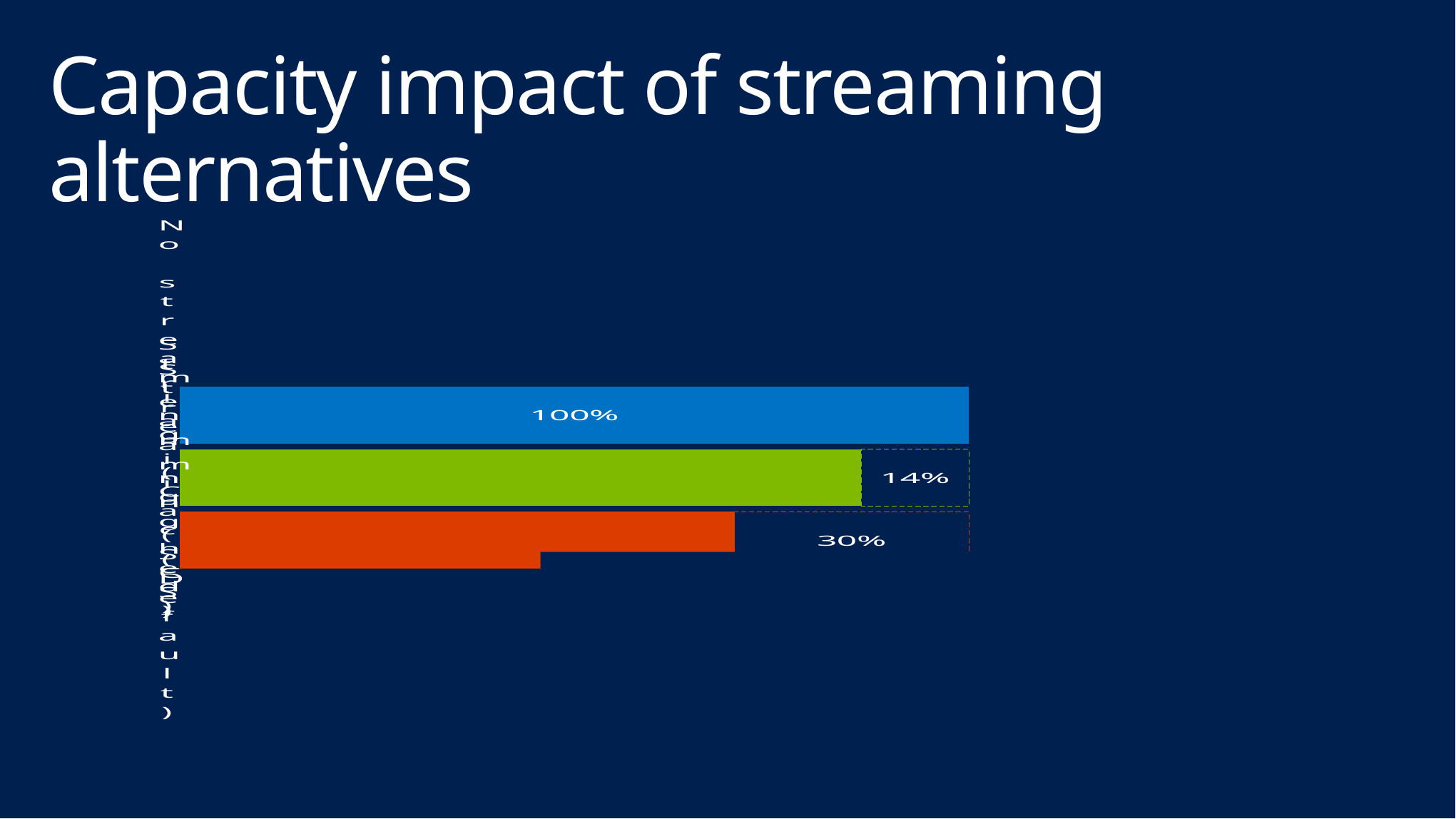
What is the difference between the labelled values of the top (blue) bar and the middle (green) bar? 86% What value is labelled on the top (blue) bar? 100% What colour is the bar labelled 100%? blue Which bar has the highest labelled value? the top (blue) bar, 100% What is the title of the slide containing the chart? Capacity impact of streaming alternatives How many bars are plotted in the chart? 3 What value is labelled on the middle (green) bar? 14% Which bar has the smallest labelled value? the middle (green) bar, 14% What value is labelled on the bottom (red) bar? 30% What is the difference between the labelled values of the bottom (red) bar and the middle (green) bar? 16% Which has the larger labelled value, the middle (green) bar or the bottom (red) bar? the bottom (red) bar What type of chart is shown on the slide? bar chart